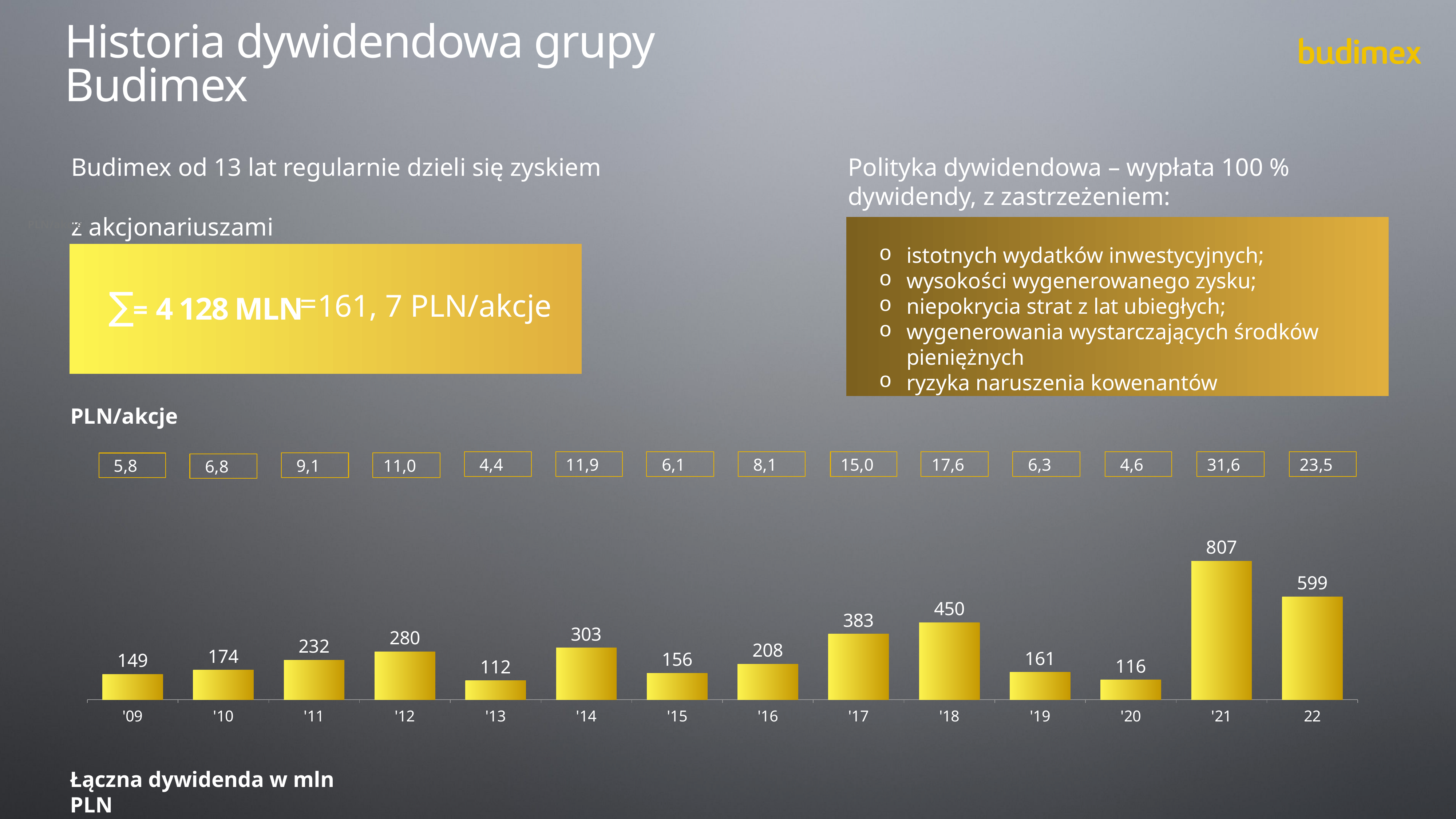
What unit label is given below the bar chart? Łączna dywidenda w mln PLN Which year has the lowest bar in the chart? '13 What is the value of the bar for '18? 450 Which year has the highest bar in the chart? '21 How many bars (years) are shown in the bar chart? 14 Which is larger in the bar chart, the value for '17 or the value for '18? '18 Do the bar values rise or fall from '16 to '18? Rise What kind of chart is used to show the total dividend by year? Bar chart What is the difference between the values for '21 and 22 in the bar chart? 208 What value does the bar chart show for '13? 112 What is the difference between the values for '14 and '15 in the bar chart? 147 What is the total dividend value shown for '21 in the bar chart? 807